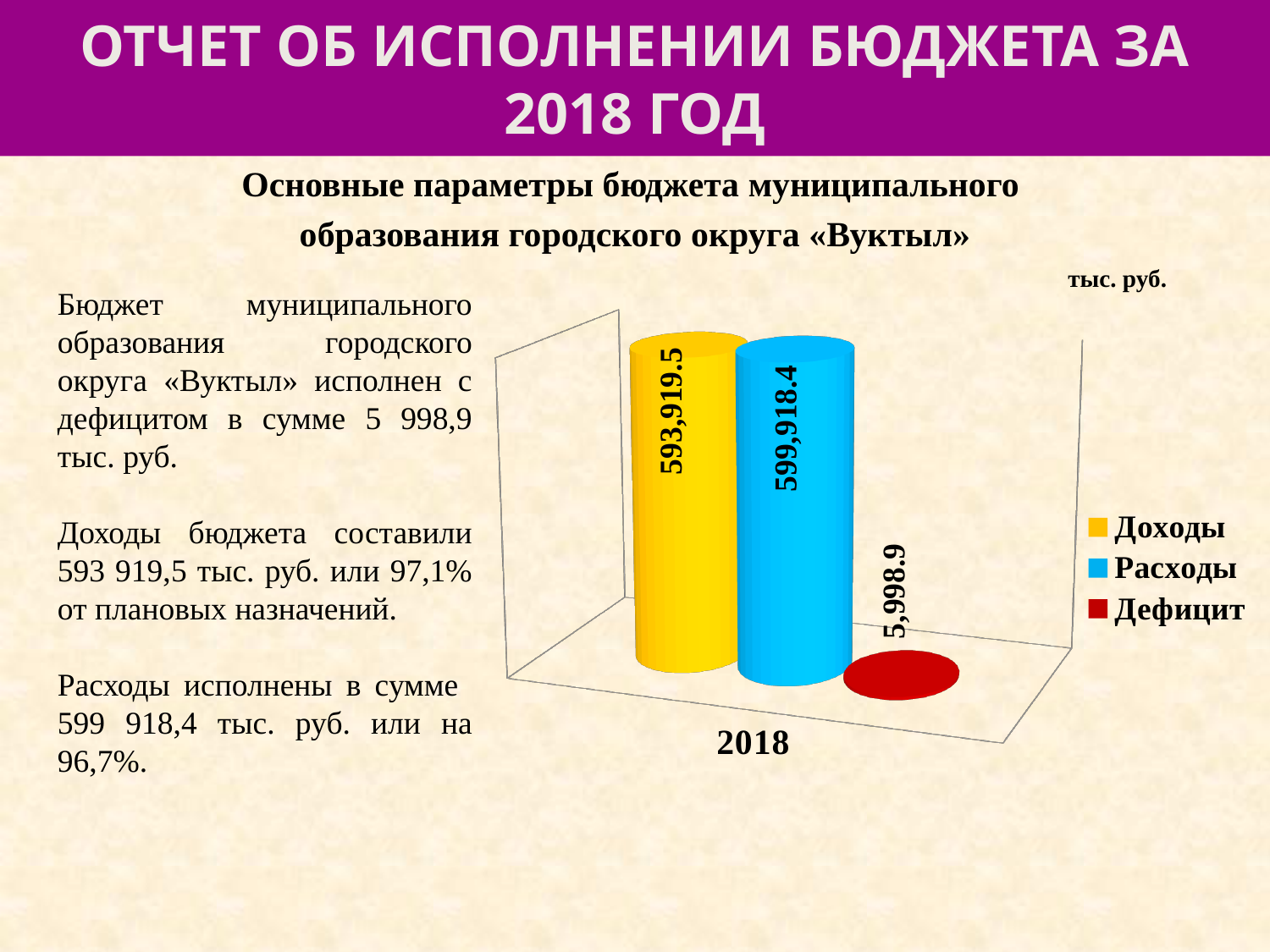
Which series has the highest value in the chart? Расходы How many series does the chart legend list? 3 What unit label is shown above the chart? тыс. руб. Which series has the lowest value in the chart? Дефицит What is the value for Расходы in the chart? 599,918.4 What kind of chart is shown on the slide? bar chart What is the value for Доходы in the chart? 593,919.5 How many categories are shown on the x axis of the chart? 1 What is the value for Дефицит in the chart? 5,998.9 What is the difference between Расходы and Доходы in the chart? 5,998.9 What colour represents Дефицит in the chart legend? red Which is larger in the chart, Доходы or Расходы? Расходы